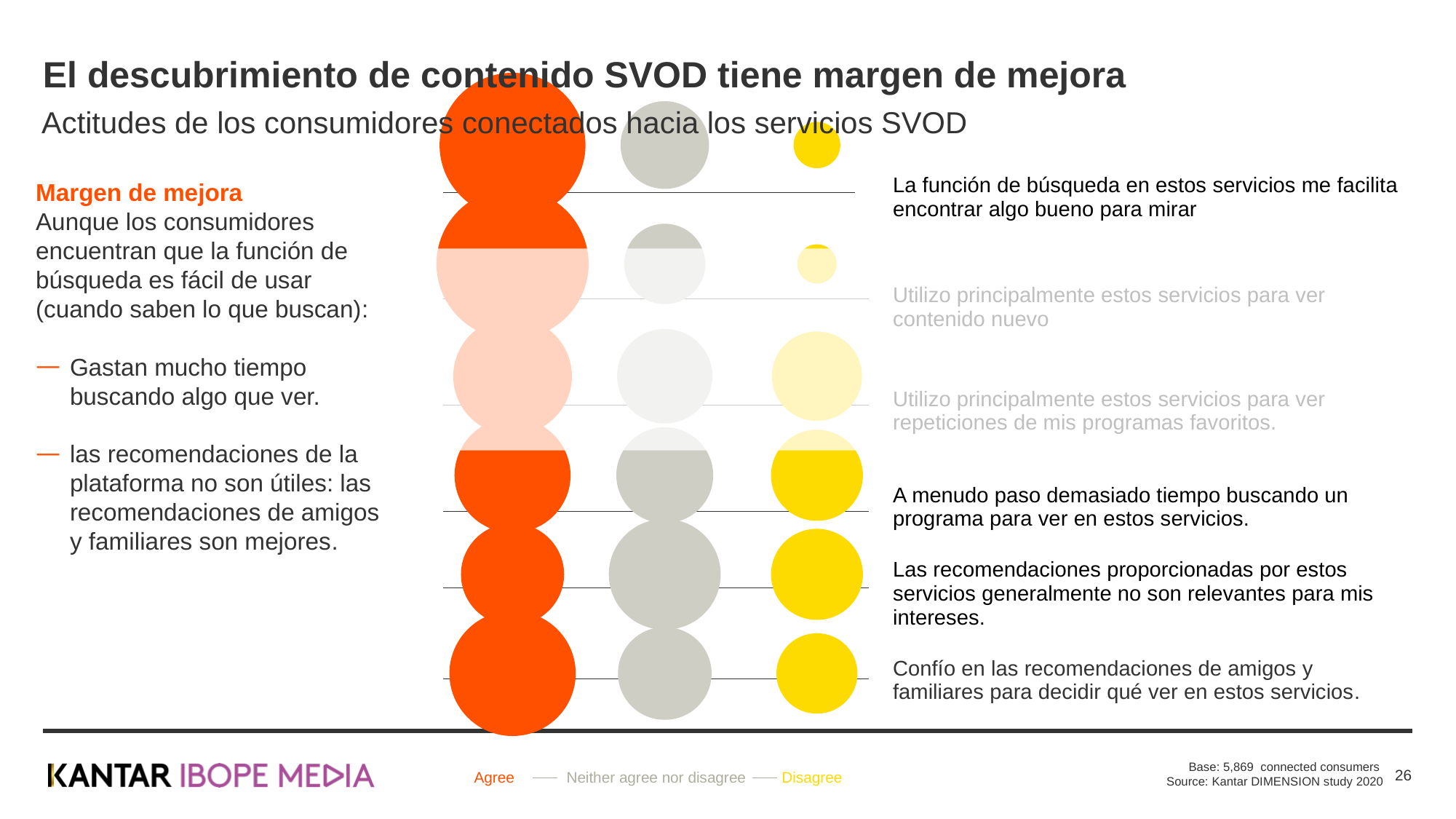
How many statements (categories) are plotted in the chart? 6 For the statement "Confío en las recomendaciones de amigos y familiares para decidir qué ver en estos servicios", which is larger: Agree or Disagree? Agree How many series does the legend list? 3 Which series is shown in orange in the chart? Agree Which statement has the smallest Disagree bubble? Utilizo principalmente estos servicios para ver contenido nuevo For the statement "La función de búsqueda en estos servicios me facilita encontrar algo bueno para mirar", which is larger: Agree or Neither agree nor disagree? Agree For the statement "La función de búsqueda en estos servicios me facilita encontrar algo bueno para mirar", which is larger: Agree or Disagree? Agree Which series is shown in yellow in the chart? Disagree What kind of chart is shown on the slide? Bubble chart